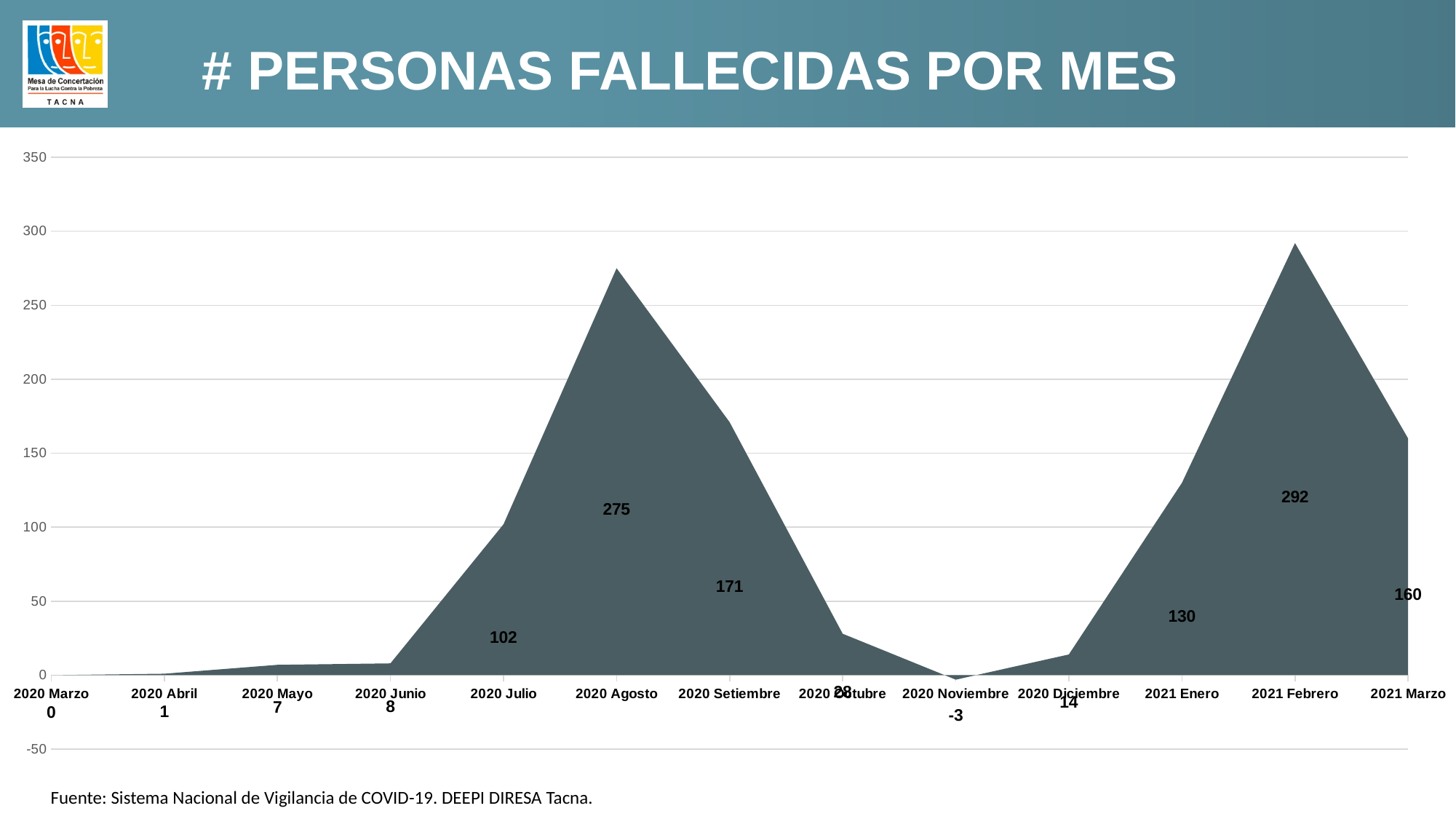
What is the value for 2020 Agosto? 275 Which is larger, the value for 2020 Setiembre or the value for 2021 Marzo? 2020 Setiembre Do the values rise or fall from 2020 Noviembre to 2021 Febrero? Rise What is the difference between the values for 2021 Febrero and 2020 Agosto? 17 What is the value for 2021 Enero? 130 What is the value for 2021 Febrero? 292 What is the value for 2020 Noviembre? -3 How many months are plotted on the x axis? 13 What kind of chart is shown on the slide? Area chart Which month has the lowest value? 2020 Noviembre Which month has the highest value? 2021 Febrero What is the title of the chart? # PERSONAS FALLECIDAS POR MES